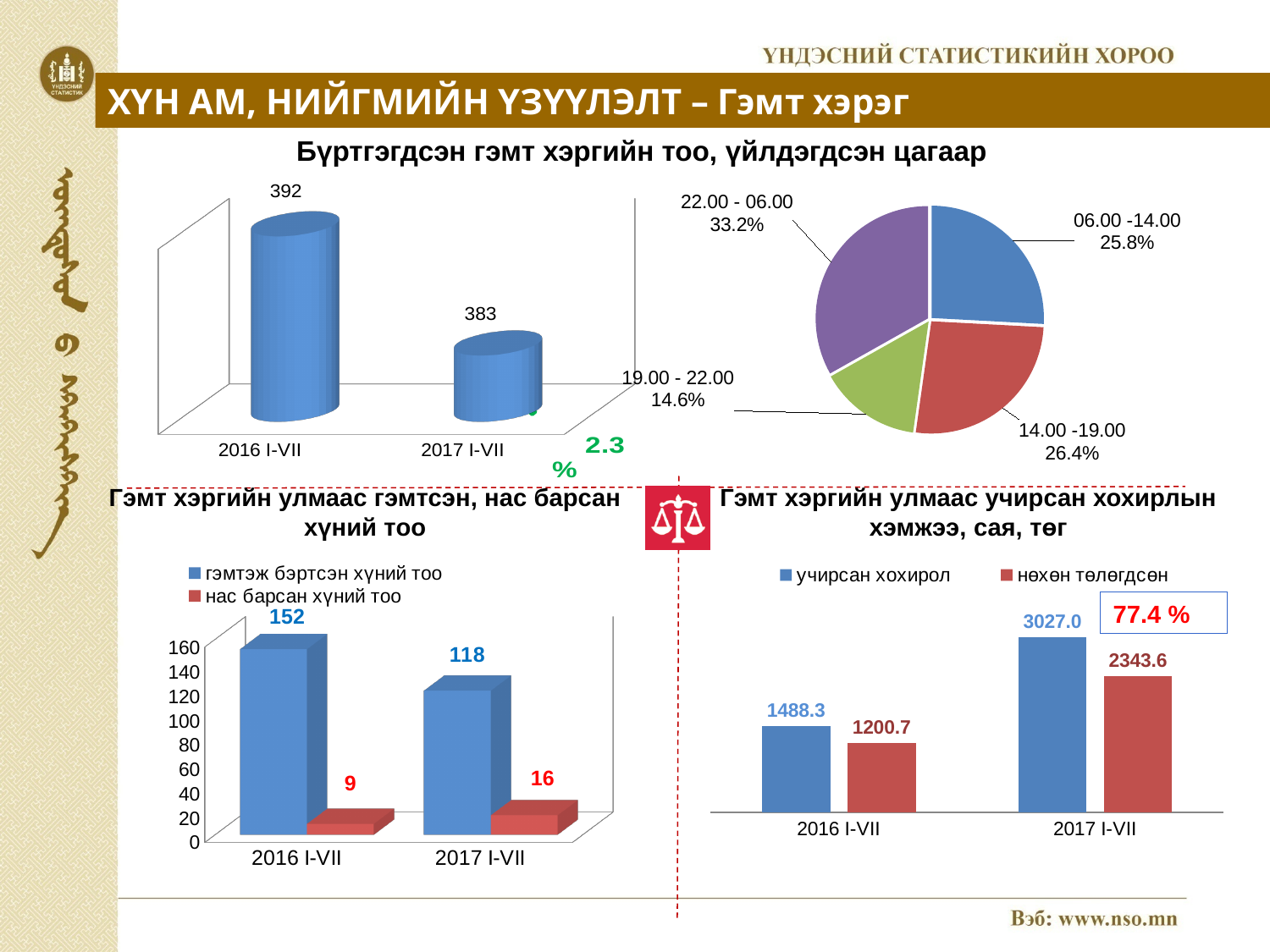
In the chart 'Гэмт хэргийн улмаас гэмтсэн, нас барсан хүний тоо', what is the value of 'нас барсан хүний тоо' for 2017 I-VII? 16 In the chart 'Гэмт хэргийн улмаас гэмтсэн, нас барсан хүний тоо', what is the value of 'гэмтэж бэртсэн хүний тоо' for 2016 I-VII? 152 In the top-left bar chart under 'Бүртгэгдсэн гэмт хэргийн тоо, үйлдэгдсэн цагаар', what is the value for 2016 I-VII? 392 How many slices does the top-right pie chart have? 4 In the top-right pie chart, which time period has the largest share? 22.00 - 06.00 In the top-left bar chart under 'Бүртгэгдсэн гэмт хэргийн тоо, үйлдэгдсэн цагаар', what is the value for 2017 I-VII? 383 In the chart 'Гэмт хэргийн улмаас учирсан хохирлын хэмжээ, сая, төг', what is the value of 'учирсан хохирол' for 2017 I-VII? 3027.0 In the chart 'Гэмт хэргийн улмаас учирсан хохирлын хэмжээ, сая, төг', which is larger for 2016 I-VII: 'учирсан хохирол' or 'нөхөн төлөгдсөн'? учирсан хохирол In the top-right pie chart, what share does the '22.00 - 06.00' slice have? 33.2% In the top-right pie chart, which time period has the smallest share? 19.00 - 22.00 In the chart 'Гэмт хэргийн улмаас гэмтсэн, нас барсан хүний тоо', how many series does the legend list? 2 In the top-left bar chart under 'Бүртгэгдсэн гэмт хэргийн тоо, үйлдэгдсэн цагаар', what is the difference between the 2016 I-VII and 2017 I-VII values? 9